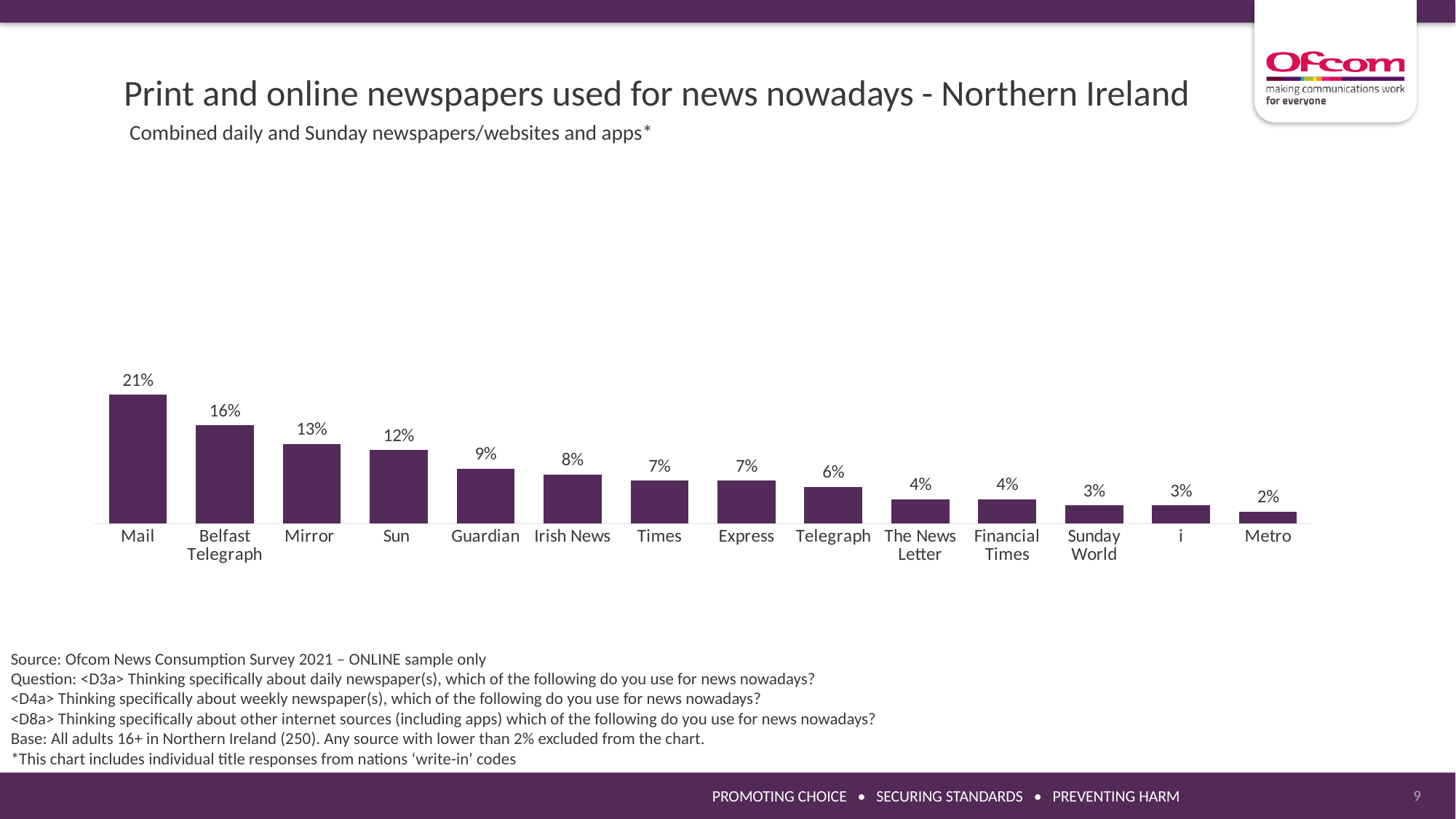
Do the values rise or fall from left to right across the chart? Fall How many newspapers are shown in the chart? 14 What is the value for Belfast Telegraph? 16% What is the difference between the values for Mail and Belfast Telegraph? 5% What is the value for Irish News? 8% What is the value for Mail? 21% Which newspaper has the lowest value? Metro Which newspaper has the highest value? Mail What is the difference between the values for Mirror and Guardian? 4% Which has a larger value, Sun or Telegraph? Sun What kind of chart is shown on the slide? Bar chart What is the value for The News Letter? 4%